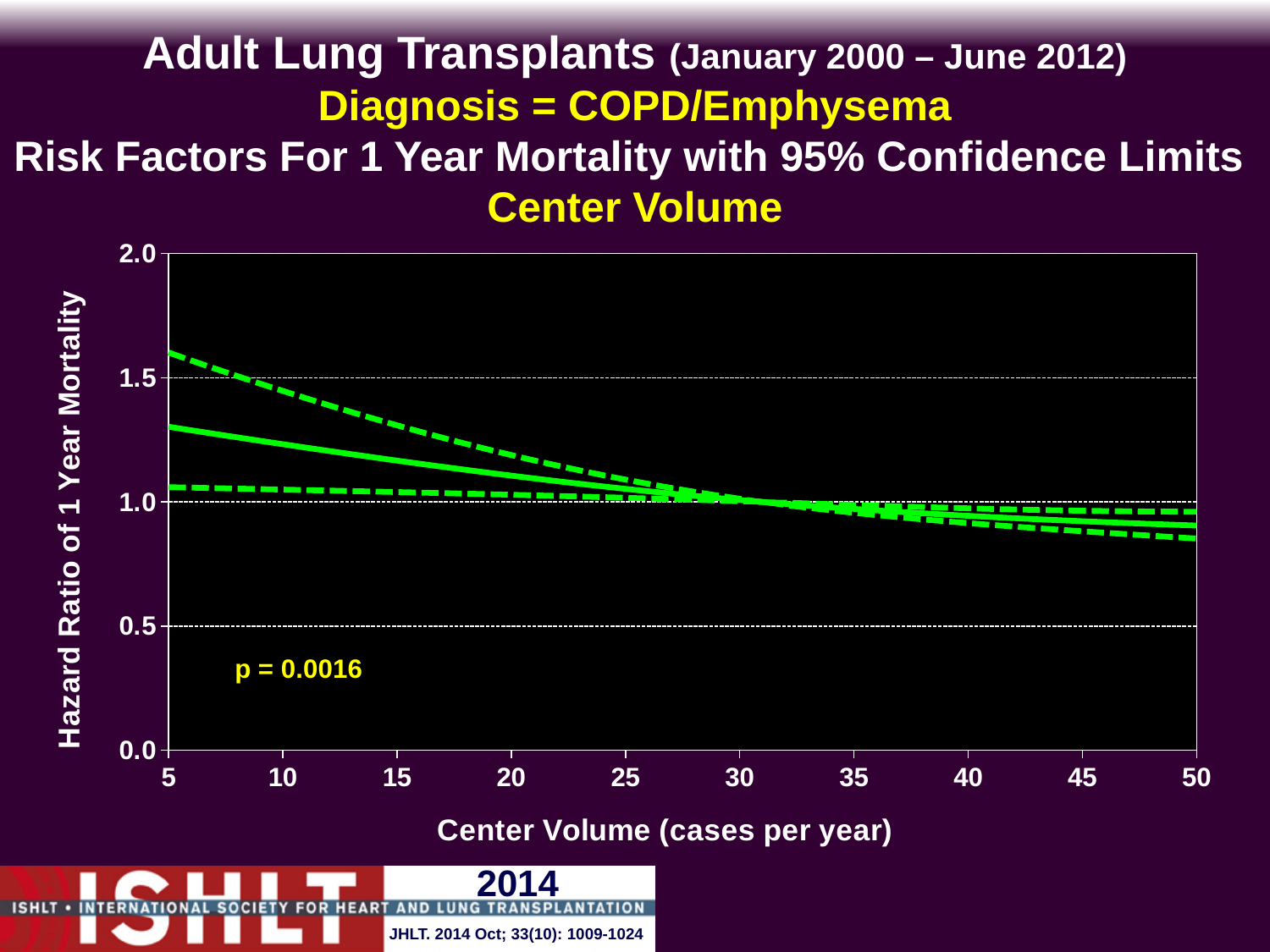
What is the label of the x axis? Center Volume (cases per year) What is the lowest center volume shown on the x axis? 5 Is the upper dashed confidence limit at a center volume of 5 cases per year greater or less than 2.0? less Is the lower dashed confidence limit at a center volume of 50 cases per year greater or less than 1.0? less Is the upper dashed confidence limit at a center volume of 5 cases per year greater or less than 1.5? greater What p-value is printed on the chart? p = 0.0016 What is the highest value shown on the y axis? 2.0 What kind of chart is shown on the slide? line chart Does the solid hazard ratio line rise or fall as center volume increases from 5 to 50 cases per year? fall How many lines are plotted on the chart? 3